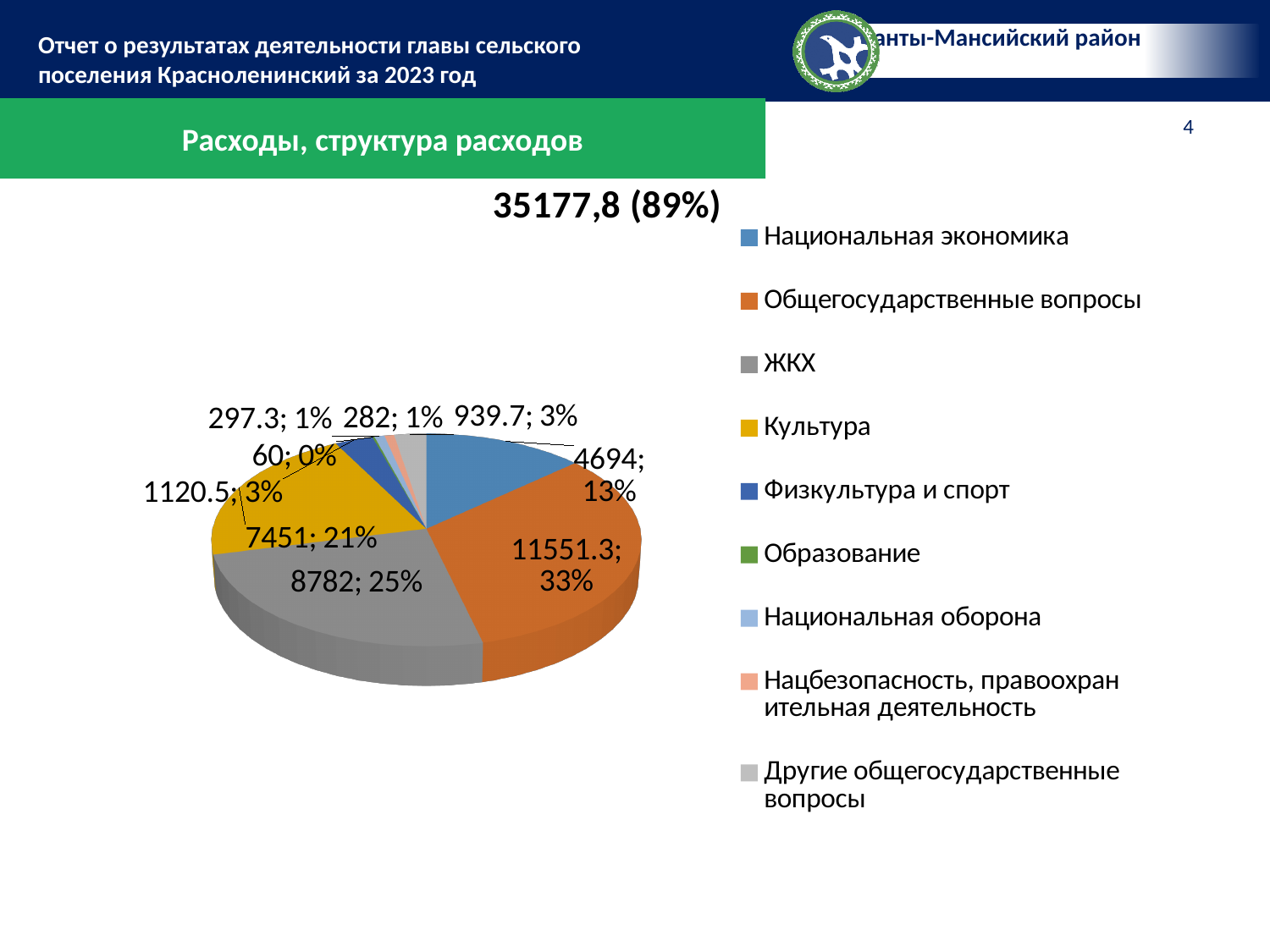
How many entries does the legend of the pie chart list? 9 What share of the pie does Физкультура и спорт have? 3% What value and share are shown for ЖКХ? 8782; 25% What is the title shown above the pie chart? 35177,8 (89%) What value and share are shown for Культура? 7451; 21% Which category has the smallest slice of the pie? Образование What value and share are shown for Национальная экономика? 4694; 13% What is the difference between the values for Общегосударственные вопросы and ЖКХ? 2769.3 Which is larger, the value for ЖКХ or the value for Культура? ЖКХ What kind of chart is shown on the slide? pie chart Which category has the largest slice of the pie? Общегосударственные вопросы What value and share are shown for Общегосударственные вопросы? 11551.3; 33%